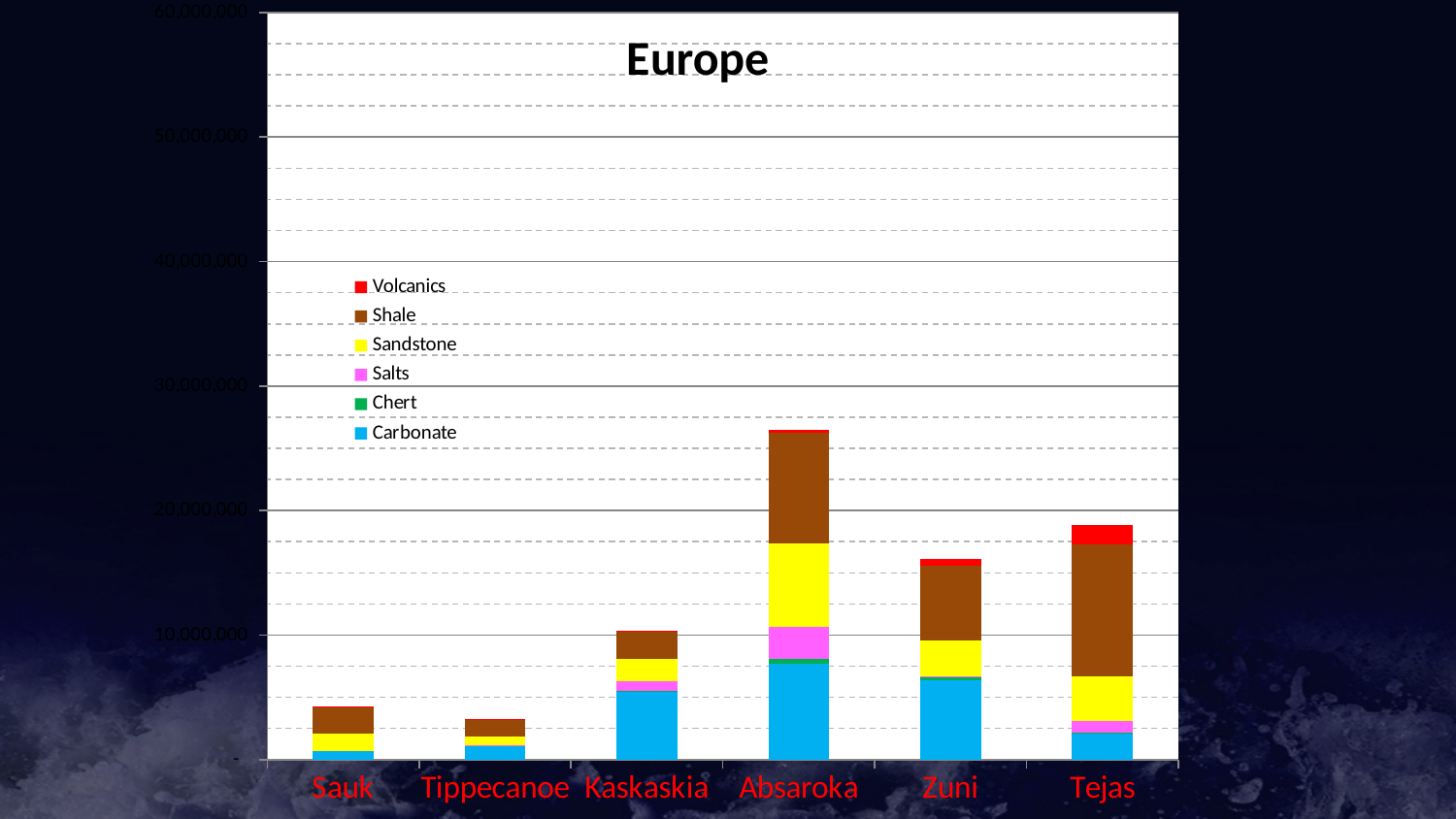
Which series is listed first (at the top) in the legend? Volcanics What is the title of the chart? Europe Is the total stacked value for Tippecanoe greater or less than 10,000,000? less How many series does the legend list? 6 Which category has the shortest stacked bar? Tippecanoe Is the total stacked value for Tejas greater or less than 20,000,000? less Which has the taller stacked bar, Tejas or Zuni? Tejas Is the total stacked value for Absaroka greater or less than 20,000,000? greater How many categories are shown on the x axis of the chart? 6 Which category has the tallest stacked bar? Absaroka What kind of chart is shown on the slide? Stacked bar chart